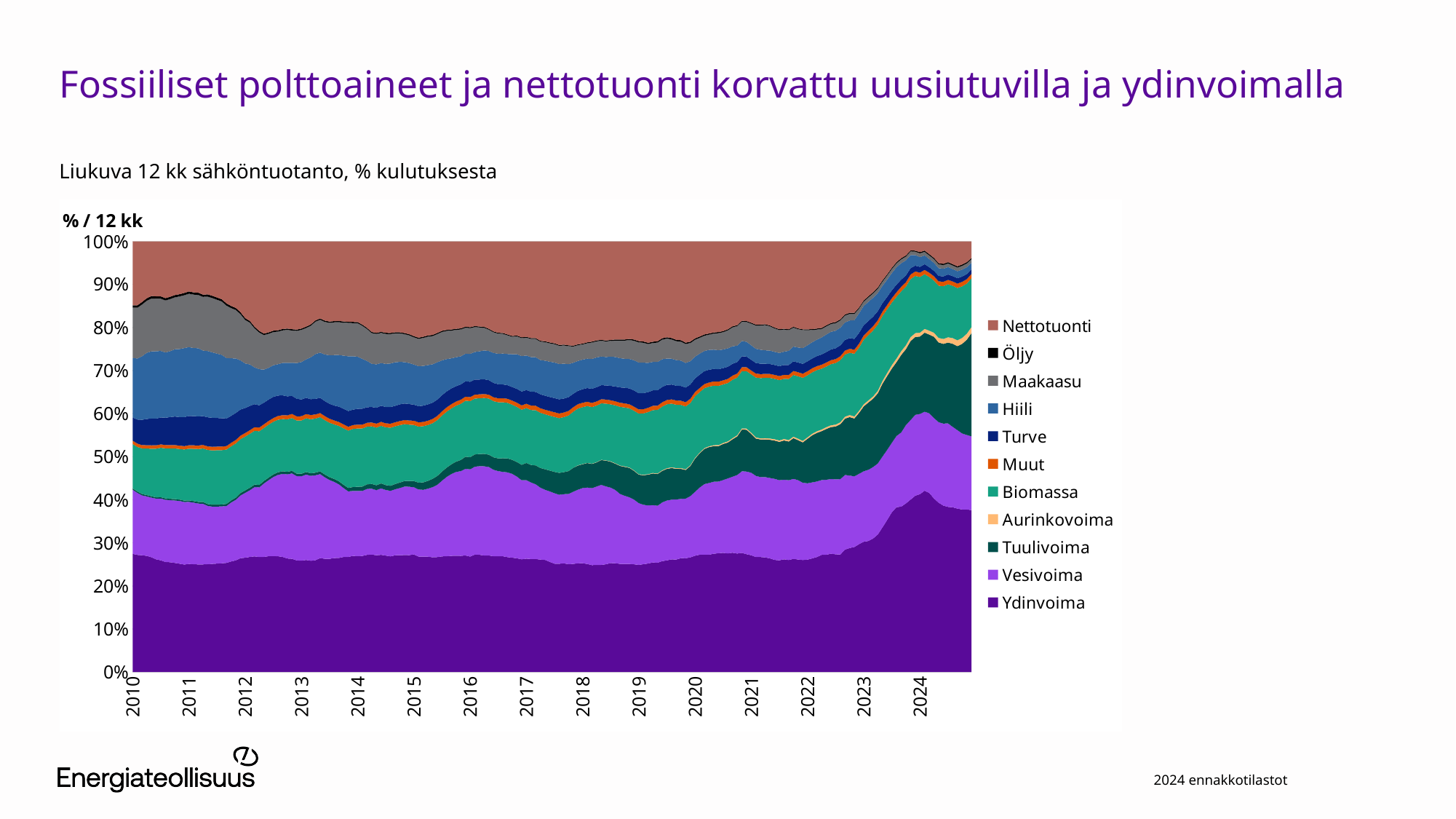
Is the share of Ydinvoima at the start of 2024 greater or less than 30%? greater At the start of 2010, which is larger: the share of Ydinvoima or the share of Vesivoima? Ydinvoima How many years are labelled on the x axis of the chart? 15 Which series is listed at the top of the chart's legend? Nettotuonti Which is larger: the share of Nettotuonti at the start of 2010 or at the start of 2024? 2010 How many series does the chart's legend list? 11 Does the share of Tuulivoima rise or fall between 2010 and 2024? rise Does the share of Nettotuonti rise or fall between 2010 and 2024? fall What is the label shown above the y axis of the chart? % / 12 kk Is the share of Ydinvoima at the start of 2010 greater or less than 30%? less Does the share of Ydinvoima rise or fall between 2010 and 2024? rise What kind of chart is shown on the slide? Stacked area chart